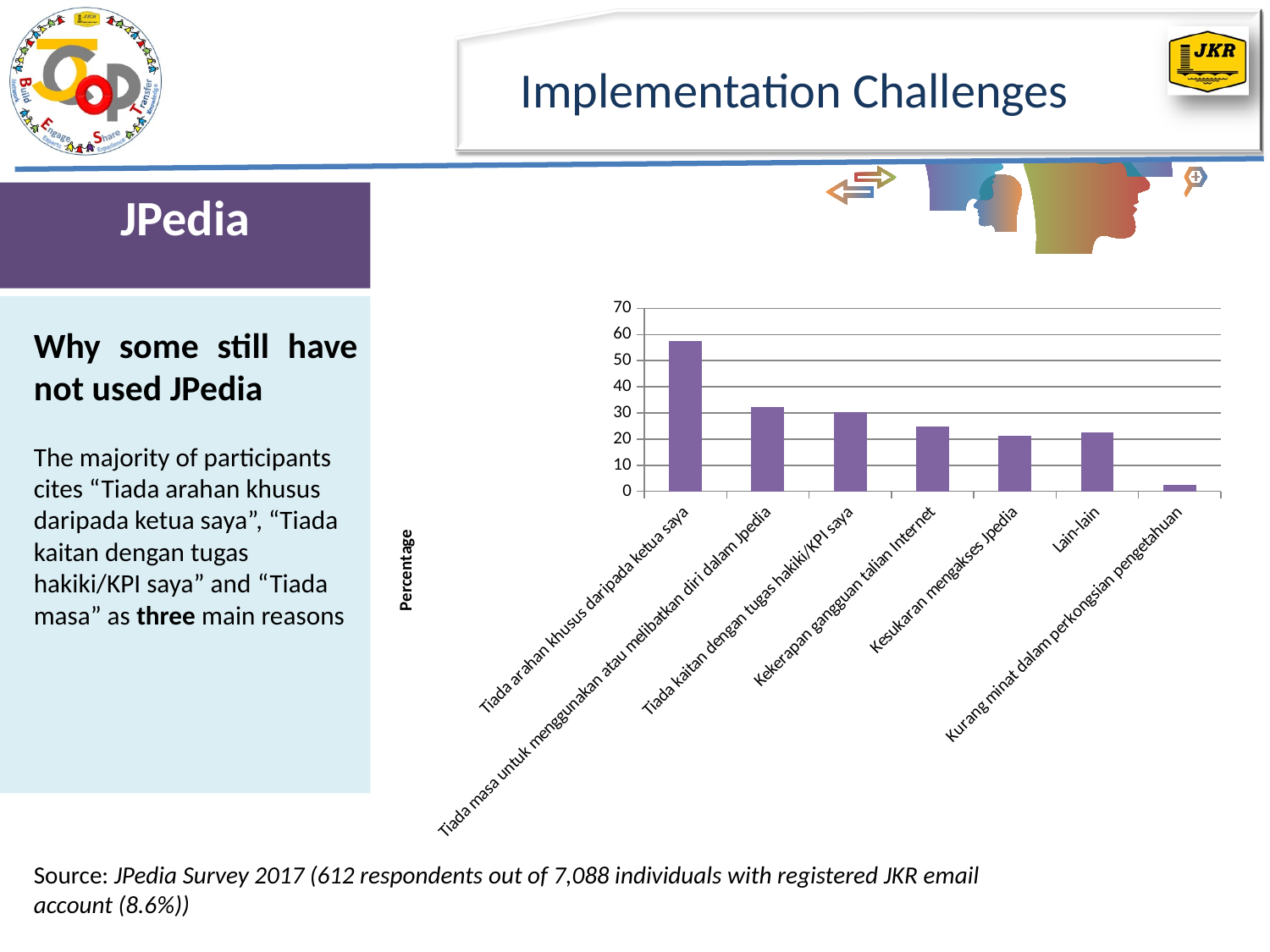
What is the label on the vertical axis of the chart? Percentage How many categories (reasons) are plotted on the chart? 7 Which reason has the lowest bar on the chart? Kurang minat dalam perkongsian pengetahuan Is the value for "Kekerapan gangguan talian Internet" greater or less than 30? less Is the value for "Tiada masa untuk menggunakan atau melibatkan diri dalam Jpedia" greater or less than 20? greater Which reason has the highest bar on the chart? Tiada arahan khusus daripada ketua saya Which is larger: the value for "Tiada arahan khusus daripada ketua saya" or for "Tiada masa untuk menggunakan atau melibatkan diri dalam Jpedia"? Tiada arahan khusus daripada ketua saya Is the value for "Kurang minat dalam perkongsian pengetahuan" greater or less than 10? less Which is larger: the value for "Tiada kaitan dengan tugas hakiki/KPI saya" or for "Kekerapan gangguan talian Internet"? Tiada kaitan dengan tugas hakiki/KPI saya What kind of chart is shown on the slide? bar chart